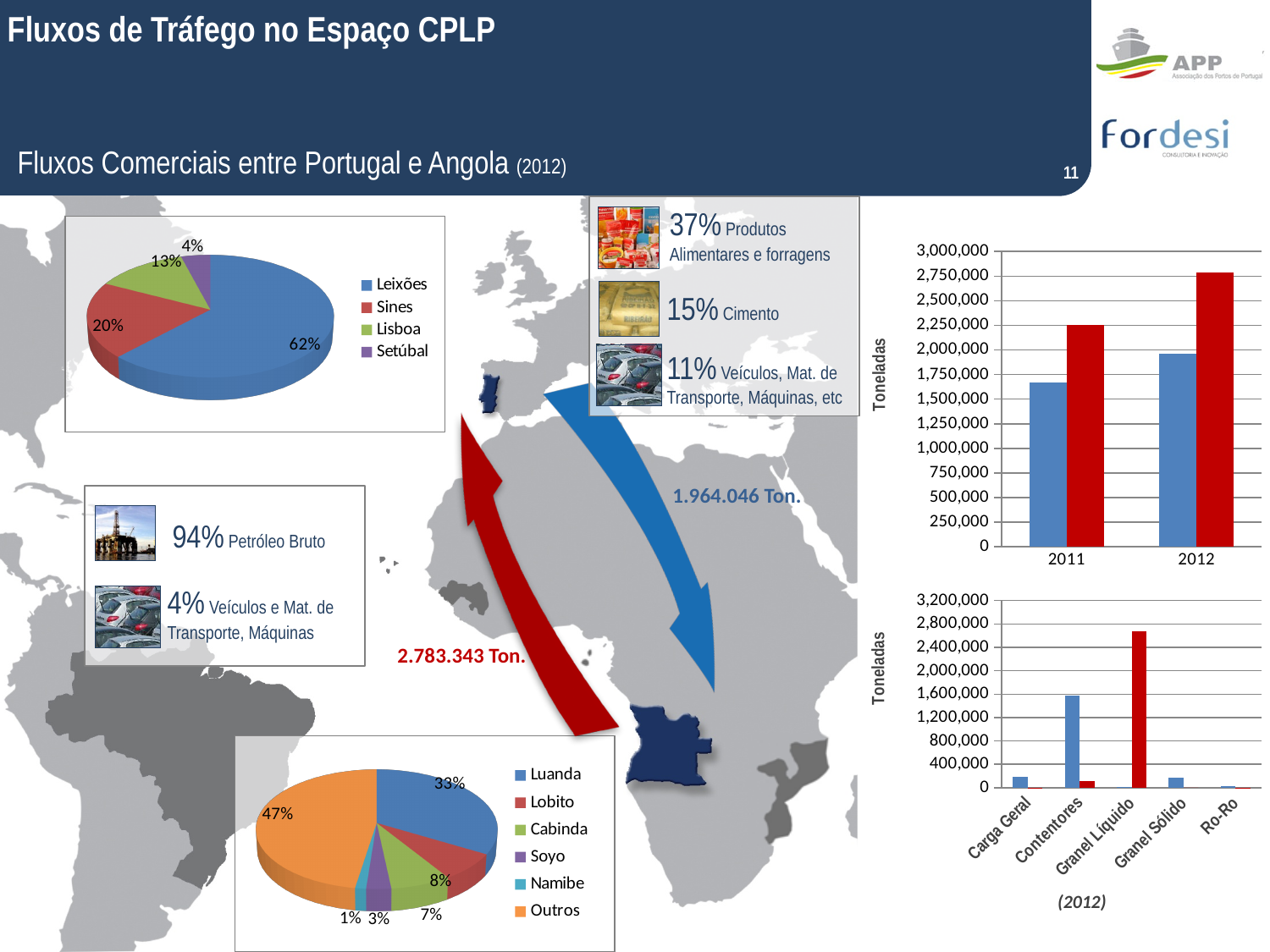
In the top-left pie chart, what share does Leixões have? 62% What kind of chart is the top-right chart showing 2011 and 2012? Bar chart In the bottom-right bar chart, is the value of the blue bar for Contentores greater or less than 1,200,000? greater How many slices does the top-left pie chart have? 4 In the top-left pie chart, which port has the smallest share? Setúbal In the top-left pie chart, what is the difference between the shares of Sines and Lisboa? 7% In the top-right bar chart, is the value of the red bar for 2012 greater or less than 2,500,000? greater In the bottom-left pie chart, which category has the largest share? Outros In the bottom-right bar chart, which category has the tallest bar? Granel Líquido In the bottom-left pie chart, which is larger, the share of Lobito or the share of Cabinda? Lobito In the bottom-left pie chart, what share does Luanda have? 33% How many categories does the legend of the bottom-left pie chart list? 6